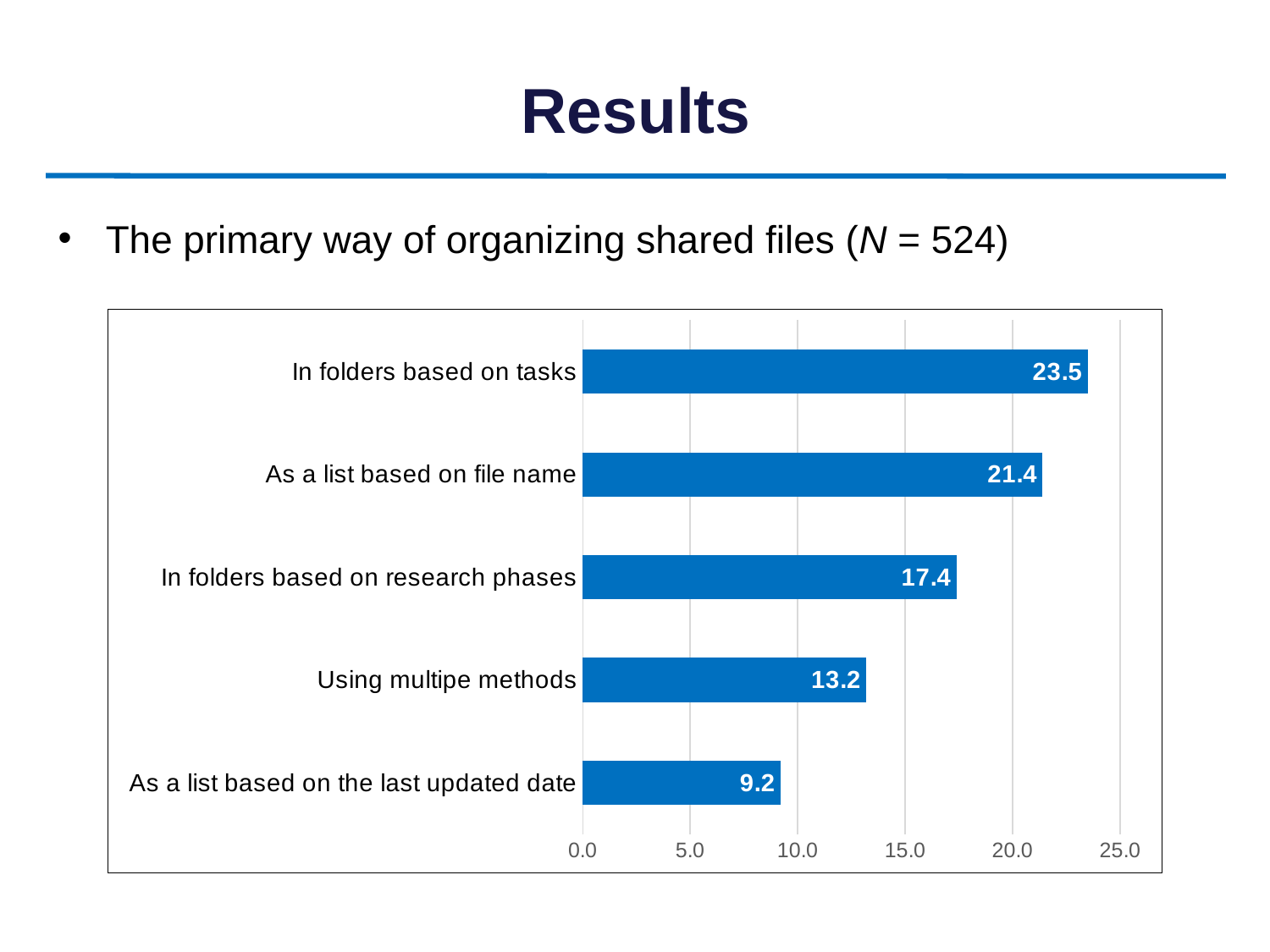
Which is larger, the value for "In folders based on research phases" or the value for "Using multipe methods"? In folders based on research phases What is the difference between the values for "Using multipe methods" and "As a list based on the last updated date"? 4.0 What is the value for "As a list based on file name"? 21.4 Which category has the highest value? In folders based on tasks Which category has the lowest value? As a list based on the last updated date What is the value for "In folders based on tasks"? 23.5 What is the value for "Using multipe methods"? 13.2 What is the difference between the values for "In folders based on tasks" and "As a list based on file name"? 2.1 What kind of chart is shown on the slide? Bar chart What is the value for "In folders based on research phases"? 17.4 How many categories are shown in the chart? 5 What is the value for "As a list based on the last updated date"? 9.2